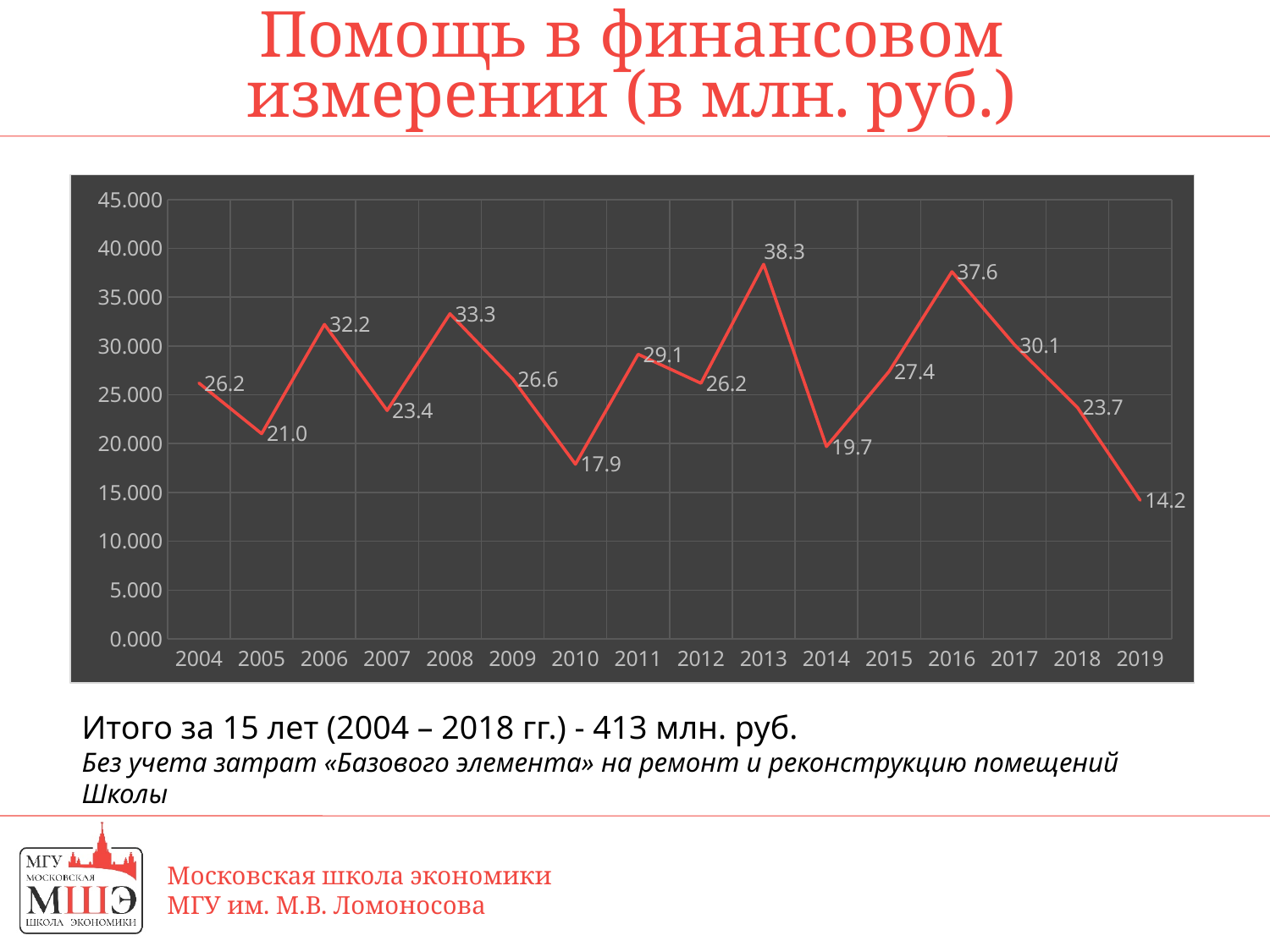
What is the value for 2019? 14.2 Which is larger, the value for 2006 or the value for 2008? 2008 What is the difference between the values for 2013 and 2014? 18.6 What is the value for 2010? 17.9 What is the title of the slide? Помощь в финансовом измерении (в млн. руб.) What kind of chart is shown on the slide? line chart What is the value for 2013? 38.3 Which year has the highest value? 2013 Do the values rise or fall from 2016 to 2019? fall Which year has the lowest value? 2019 Is the value for 2016 greater or less than 35.000? greater How many years are shown on the x axis? 16